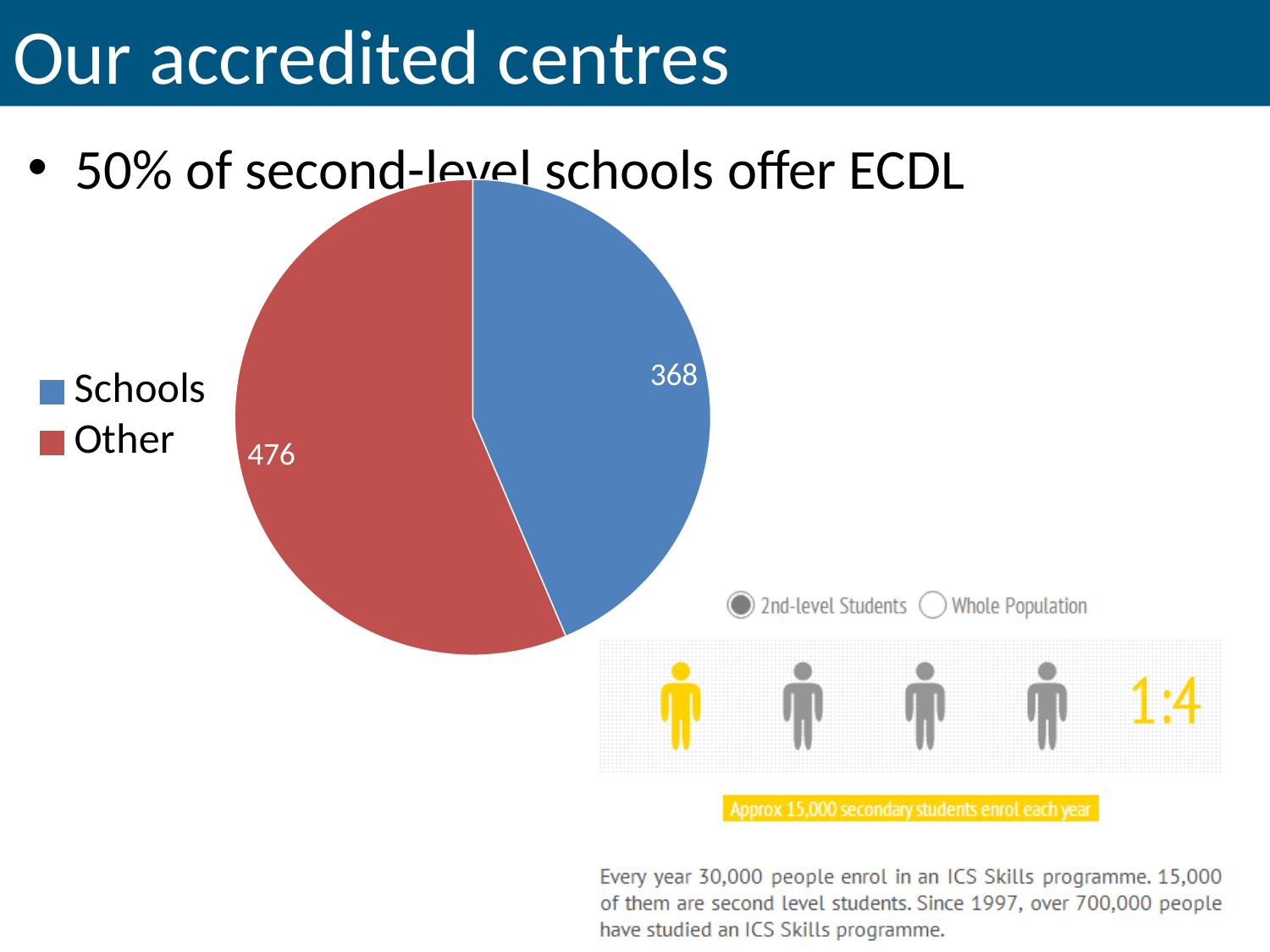
How many slices does the pie chart have? 2 Which is larger in the pie chart, Schools or Other? Other What is the total of the two values shown in the pie chart? 844 How many entries does the pie chart's legend list? 2 What value is shown for the Schools slice of the pie chart? 368 What are the two legend entries of the pie chart? Schools and Other What colour is the Schools slice in the pie chart? Blue Which slice of the pie chart is the smallest? Schools What value is shown for the Other slice of the pie chart? 476 What is the difference between the Other value and the Schools value in the pie chart? 108 Which slice of the pie chart is the largest? Other What kind of chart is shown on the slide? Pie chart